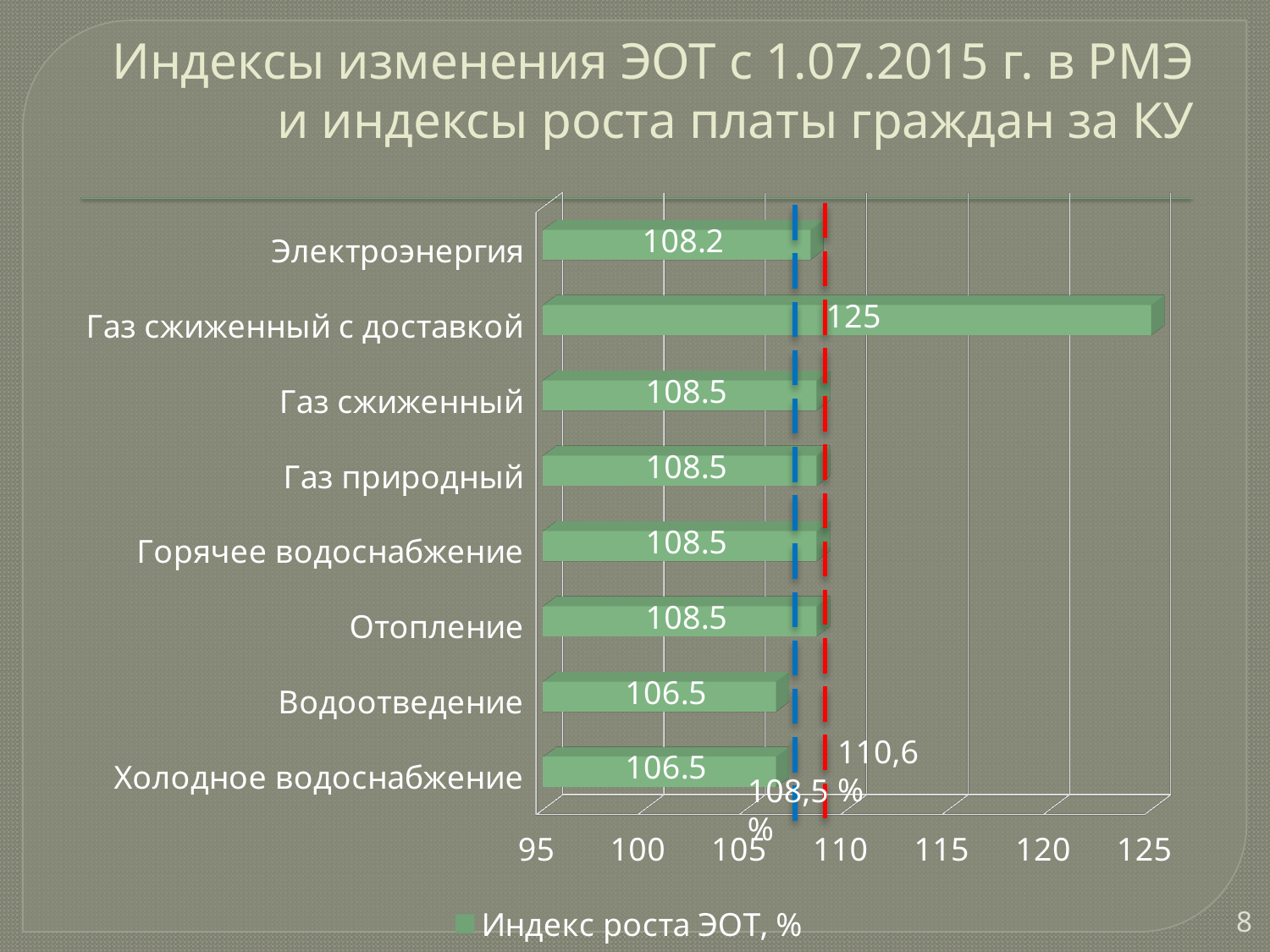
What is the value for Водоотведение? 106.5 Which is larger, the value for Газ природный or the value for Водоотведение? Газ природный What is the difference between the values for Газ сжиженный с доставкой and Газ сжиженный? 16.5 What series name does the legend show? Индекс роста ЭОТ, % What is the value for Электроэнергия? 108.2 What is the difference between the values for Электроэнергия and Холодное водоснабжение? 1.7 What is the value for Отопление? 108.5 How many categories are shown in the chart? 8 Which category has the highest value? Газ сжиженный с доставкой What kind of chart is shown on the slide? bar chart What is the value for Газ сжиженный с доставкой? 125 Is the value for Газ сжиженный с доставкой greater or less than 120? greater